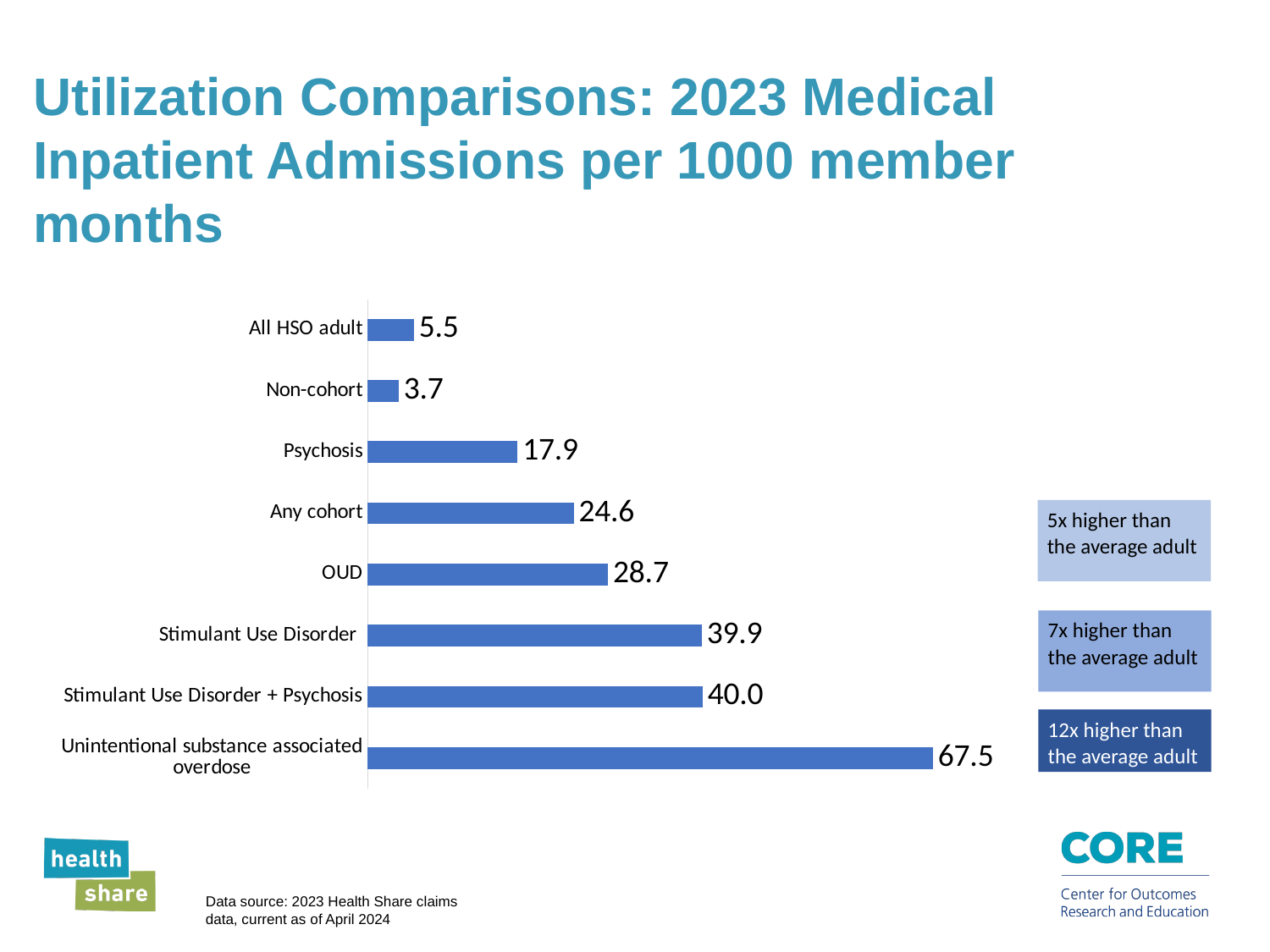
What is the value for Psychosis? 17.9 What is the value for All HSO adult? 5.5 Which category has the highest value? Unintentional substance associated overdose How many categories are shown in the chart? 8 Which category has the lowest value? Non-cohort What kind of chart is shown on the slide? Bar chart What is the value for Stimulant Use Disorder + Psychosis? 40.0 According to the annotation box, how many times higher than the average adult is the value for Unintentional substance associated overdose? 12x Which is larger, the value for OUD or the value for Psychosis? OUD What is the difference between the values for Unintentional substance associated overdose and All HSO adult? 62.0 What is the value for OUD? 28.7 What is the difference between the values for Stimulant Use Disorder and Any cohort? 15.3